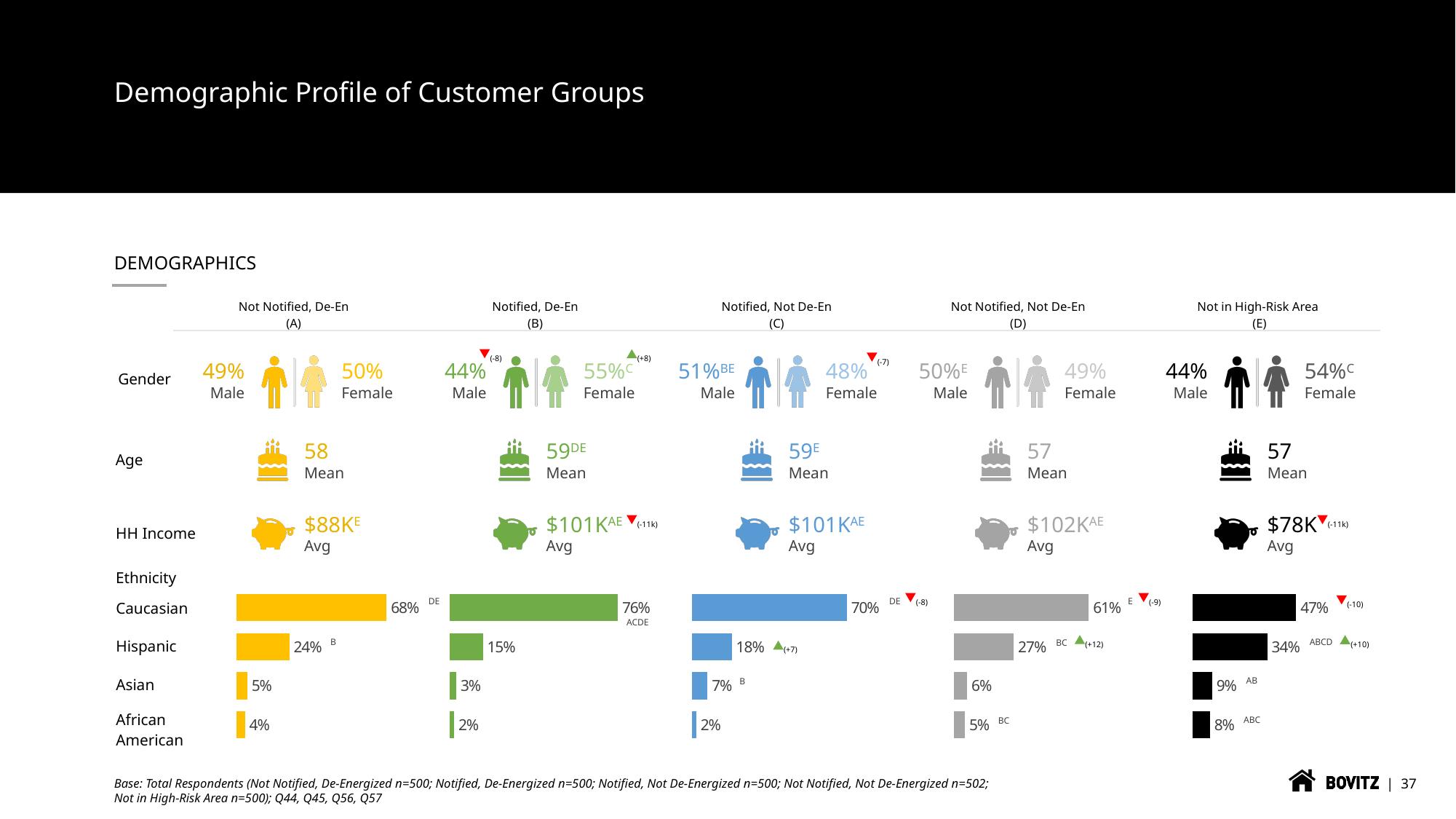
In the ethnicity bar chart for the Notified, De-En (B) group, which ethnicity has the lowest percentage? African American In the ethnicity bar chart for the Not in High-Risk Area (E) group, what is the difference between the Caucasian and Hispanic percentages? 13% How many ethnicity categories are shown in each ethnicity bar chart? 4 In the ethnicity bar chart for the Not Notified, Not De-En (D) group, what is the difference between the Hispanic and Asian percentages? 21% Comparing the ethnicity bar charts, is the Caucasian percentage larger for the Notified, De-En (B) group or the Not Notified, Not De-En (D) group? Notified, De-En (B) What colour are the bars in the ethnicity chart for the Notified, Not De-En (C) group? Blue What type of chart is used to show the ethnicity breakdown for each customer group? Bar chart In the ethnicity bar chart for the Notified, De-En (B) group, what percentage is Hispanic? 15% In the ethnicity bar chart for the Not Notified, Not De-En (D) group, what percentage is African American? 5% In the ethnicity bar chart for the Notified, Not De-En (C) group, which ethnicity has the highest percentage? Caucasian In the ethnicity bar chart for the Not in High-Risk Area (E) group, what percentage is Asian? 9% In the ethnicity bar chart for the Not Notified, De-En (A) group, what percentage is Caucasian? 68%